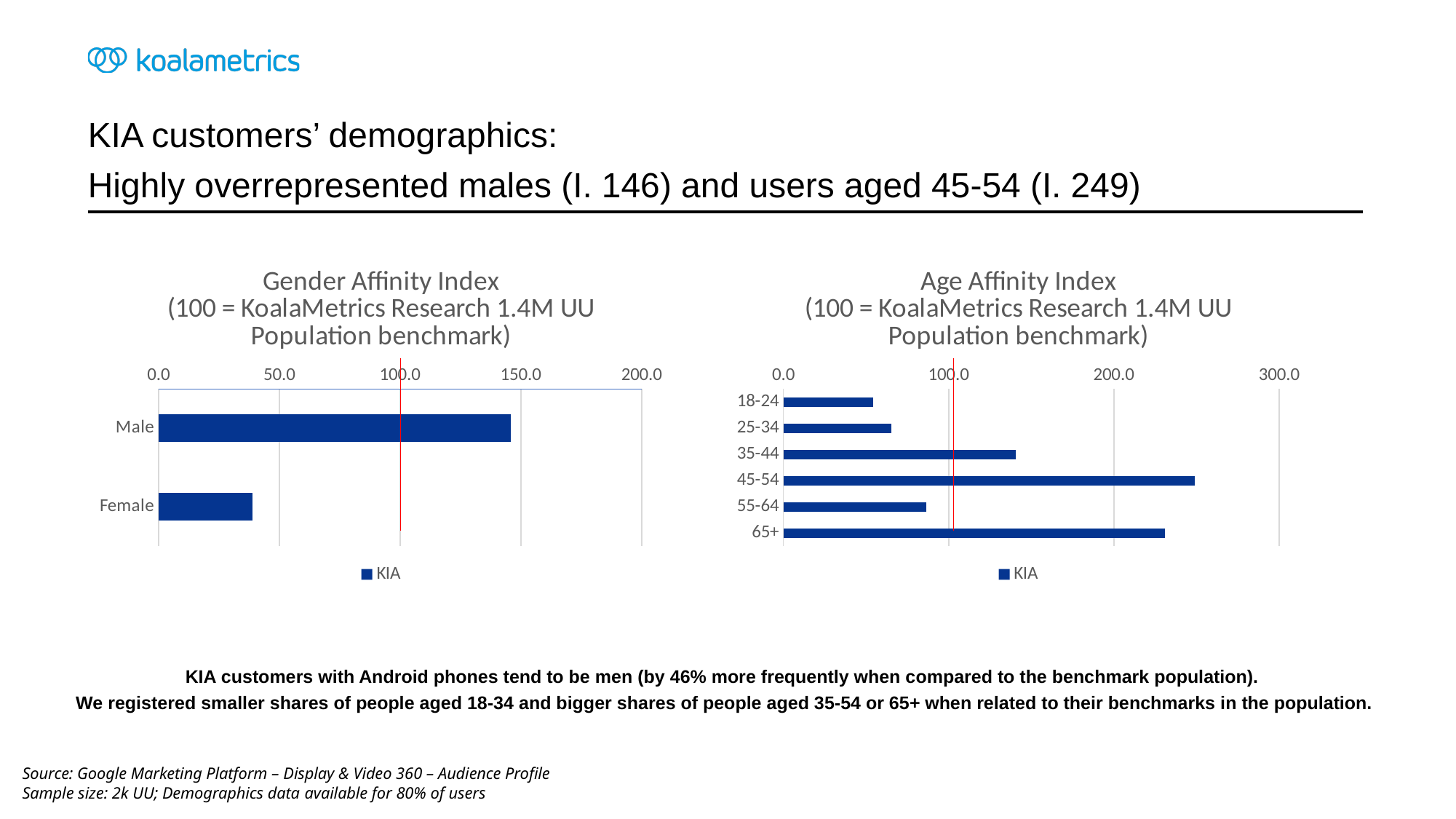
In the Gender Affinity Index chart, is the value for Female greater or less than 50.0? less In the Age Affinity Index chart, what is the index value for users aged 45-54? 249 In the Age Affinity Index chart, which age group has the lowest value? 18-24 In the Age Affinity Index chart, which age group has the highest value? 45-54 In the Age Affinity Index chart, is the value for 35-44 greater or less than 100.0? greater In the Gender Affinity Index chart, what is the index value for Male? 146 In the Age Affinity Index chart, is the value for 55-64 greater or less than 100.0? less How many series does the legend of the Age Affinity Index chart list? 1 What kind of chart is the Gender Affinity Index chart? bar chart In the Gender Affinity Index chart, which category has the larger value, Male or Female? Male How many age groups are shown in the Age Affinity Index chart? 6